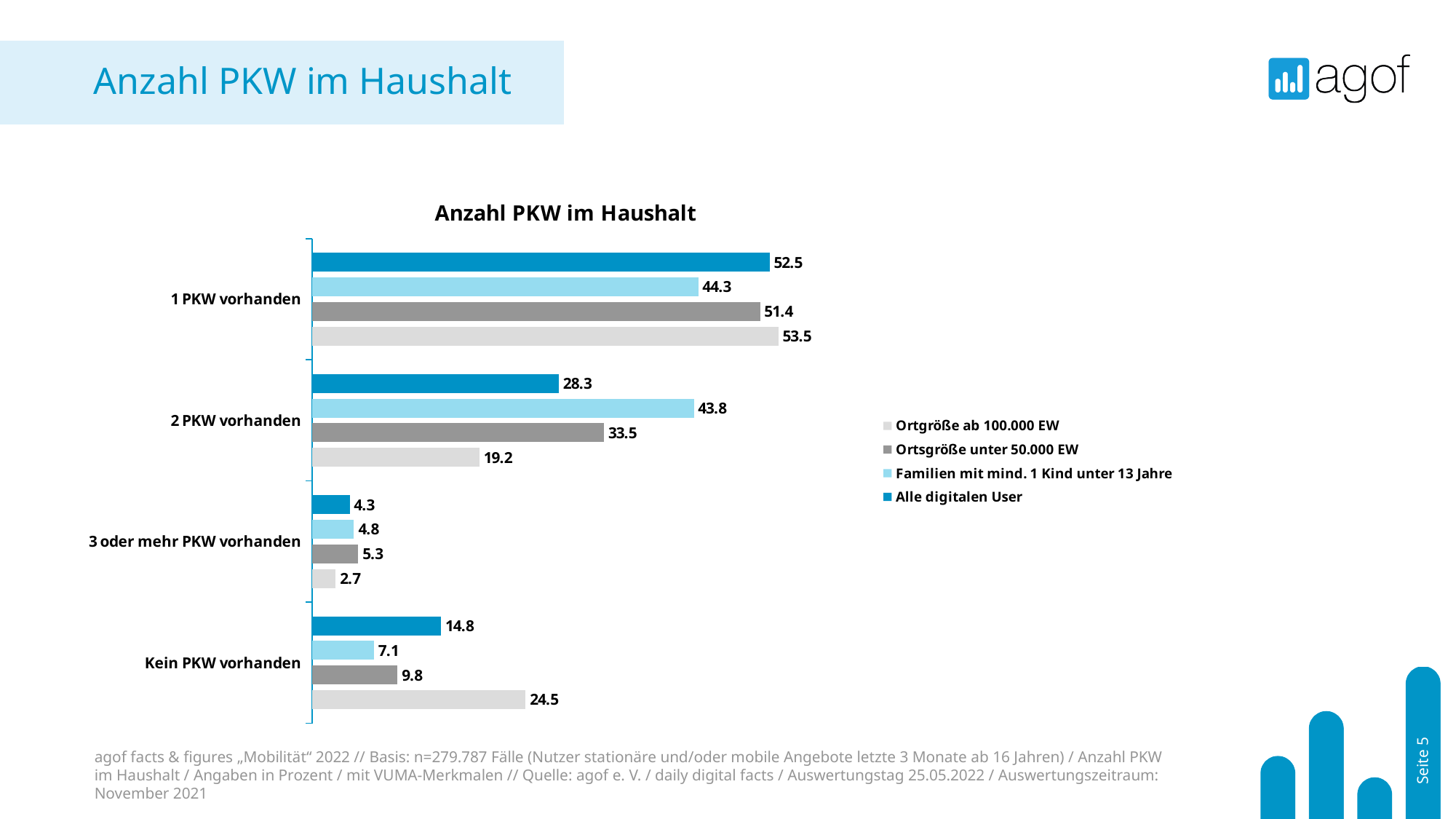
What is the difference between "Familien mit mind. 1 Kind unter 13 Jahre" and "Alle digitalen User" in the "2 PKW vorhanden" category? 15.5 What kind of chart is shown on the slide? Bar chart What is the value for "Alle digitalen User" in the "1 PKW vorhanden" category? 52.5 Which series has the lowest value in the "Kein PKW vorhanden" category? Familien mit mind. 1 Kind unter 13 Jahre How many categories are shown on the chart? 4 What is the value for "Familien mit mind. 1 Kind unter 13 Jahre" in the "2 PKW vorhanden" category? 43.8 What is the title of the chart? Anzahl PKW im Haushalt What is the value for "Ortgröße ab 100.000 EW" in the "Kein PKW vorhanden" category? 24.5 How many series does the legend list? 4 Which is larger in the "Kein PKW vorhanden" category: "Alle digitalen User" or "Ortsgröße unter 50.000 EW"? Alle digitalen User What is the value for "Ortsgröße unter 50.000 EW" in the "3 oder mehr PKW vorhanden" category? 5.3 Which series has the highest value in the "1 PKW vorhanden" category? Ortgröße ab 100.000 EW